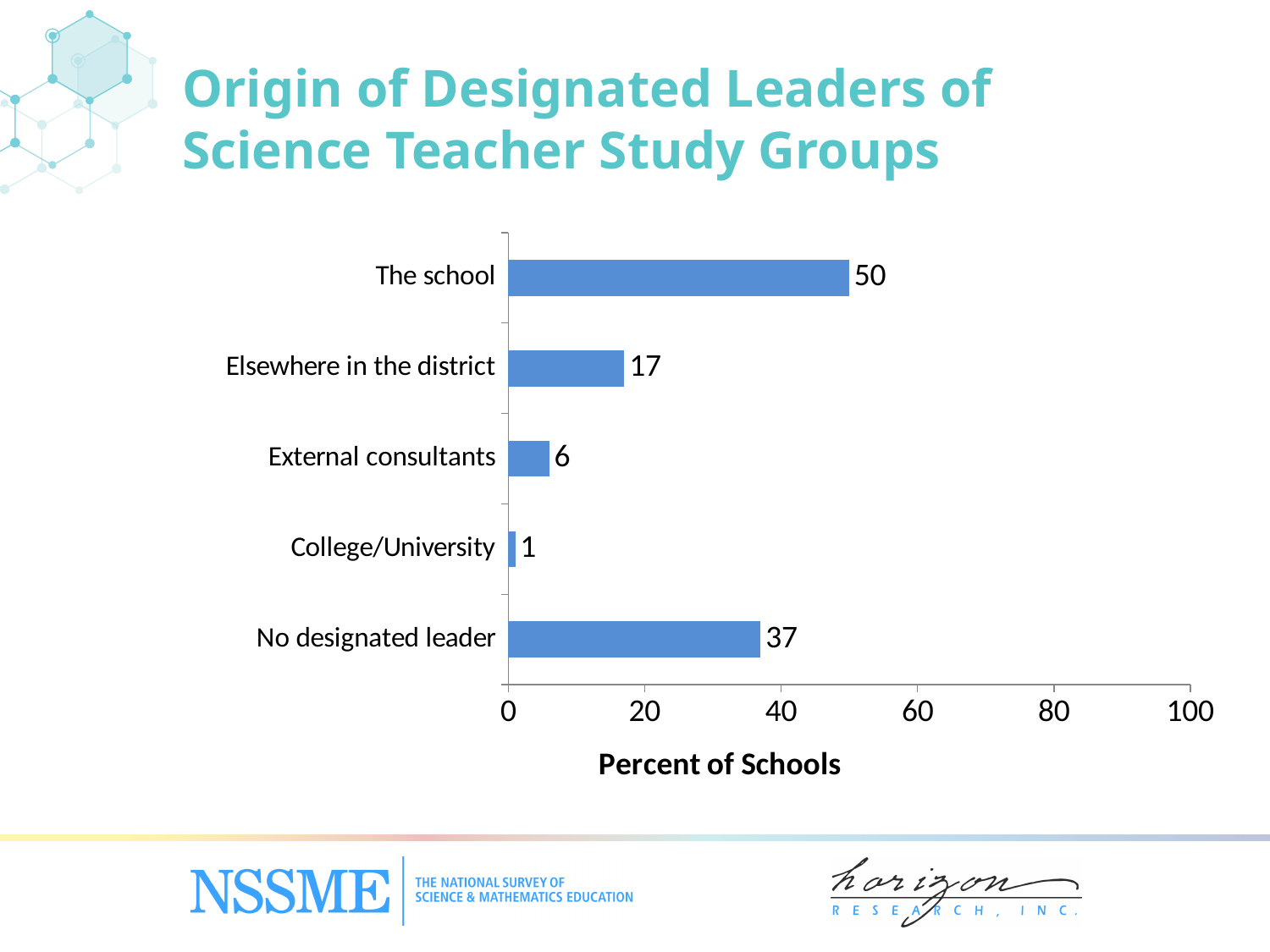
What is the value for No designated leader? 37 What is the difference between the values for The school and No designated leader? 13 What kind of chart is shown on the slide? Bar chart What is the label of the horizontal axis? Percent of Schools What is the value for External consultants? 6 What is the value for Elsewhere in the district? 17 What percent of schools have a designated leader from the school? 50 Which is larger, the value for Elsewhere in the district or External consultants? Elsewhere in the district How many categories are shown in the chart? 5 Which category has the highest value? The school Is the value for No designated leader greater or less than 40? less Which category has the lowest value? College/University